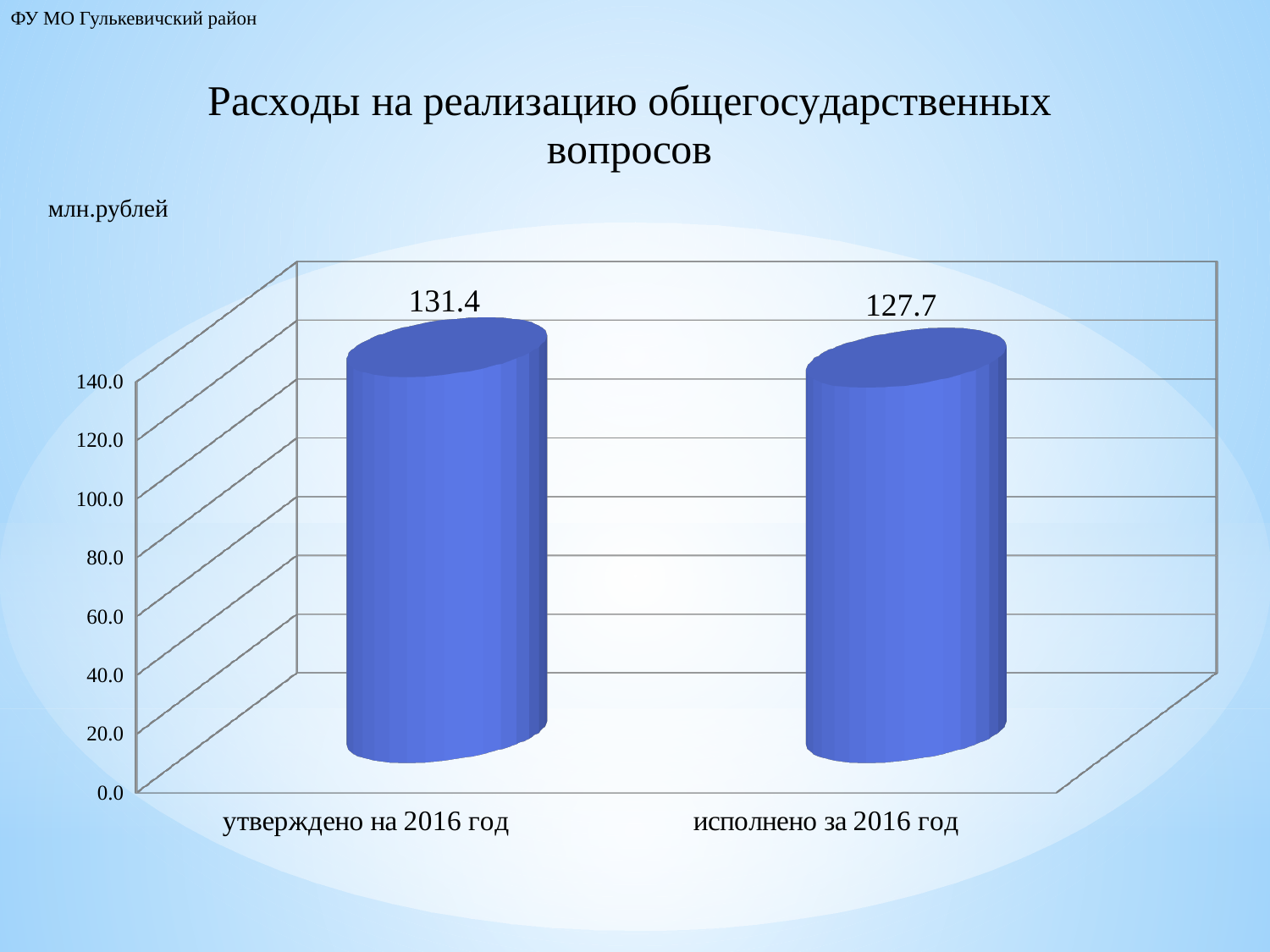
Do the values rise or fall from «утверждено на 2016 год» to «исполнено за 2016 год»? fall What is the value for «утверждено на 2016 год»? 131.4 Which category has the highest value? утверждено на 2016 год Is the value for «исполнено за 2016 год» greater or less than 120.0? greater Which is larger: the value for «утверждено на 2016 год» or the value for «исполнено за 2016 год»? утверждено на 2016 год What is the title of the chart? Расходы на реализацию общегосударственных вопросов What is the value for «исполнено за 2016 год»? 127.7 Which category has the lowest value? исполнено за 2016 год How many categories are shown on the chart? 2 What unit is indicated for the values on the chart? млн.рублей What is the difference between the value for «утверждено на 2016 год» and the value for «исполнено за 2016 год»? 3.7 What kind of chart is shown on the slide? bar chart